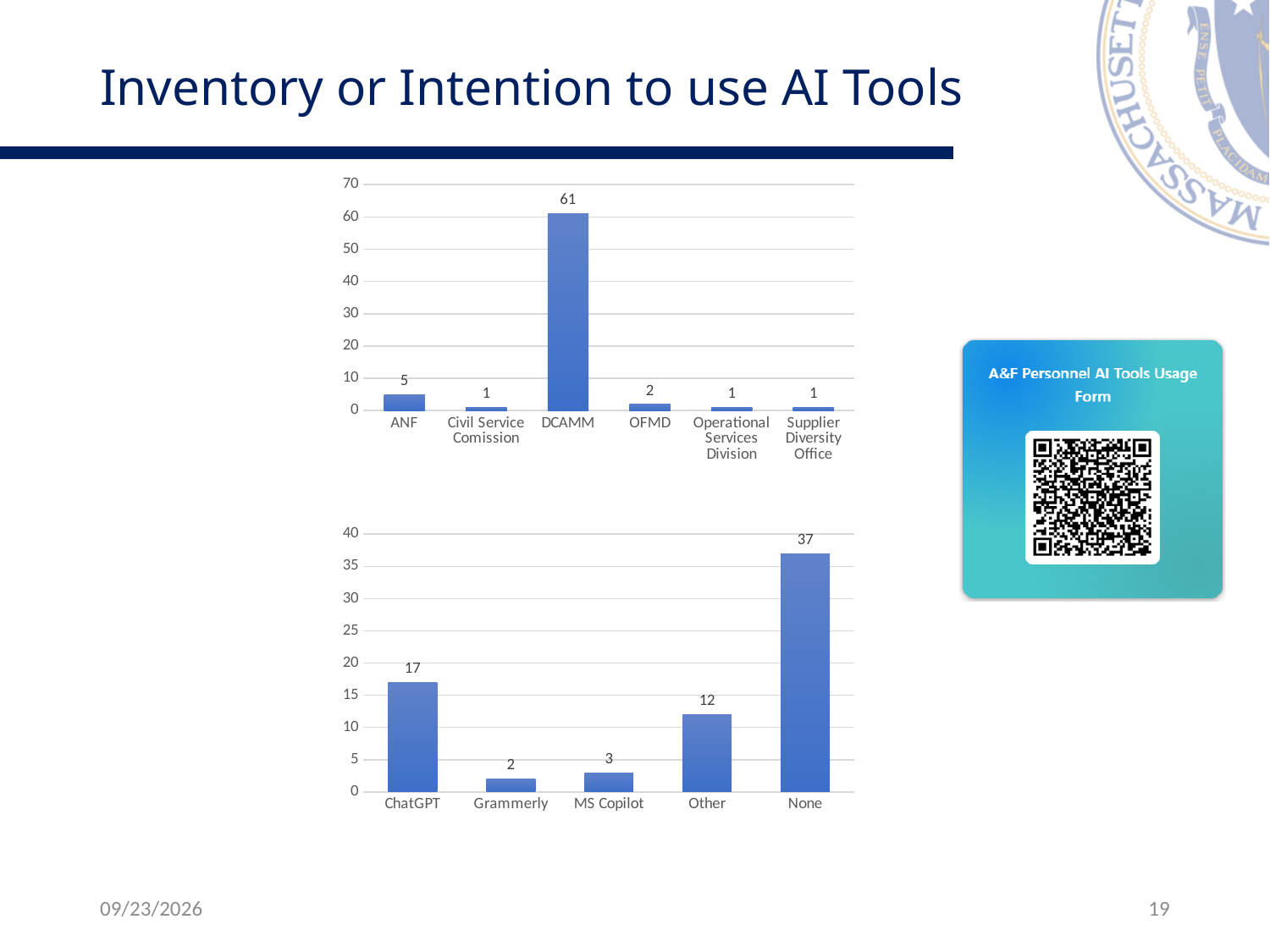
What kind of chart is the bottom chart? Bar chart In the top chart, how many categories are shown on the x axis? 6 In the bottom chart, how many categories are shown on the x axis? 5 In the bottom chart, which category has the lowest value? Grammerly In the bottom chart, what is the value for ChatGPT? 17 In the top chart, what is the value for ANF? 5 In the bottom chart, what is the difference between the values for None and Other? 25 In the top chart, which category has the highest value? DCAMM In the top chart, what is the difference between the values for DCAMM and ANF? 56 In the bottom chart, what is the value for None? 37 In the top chart, what is the value for DCAMM? 61 In the top chart, which is larger, the value for OFMD or the value for Supplier Diversity Office? OFMD